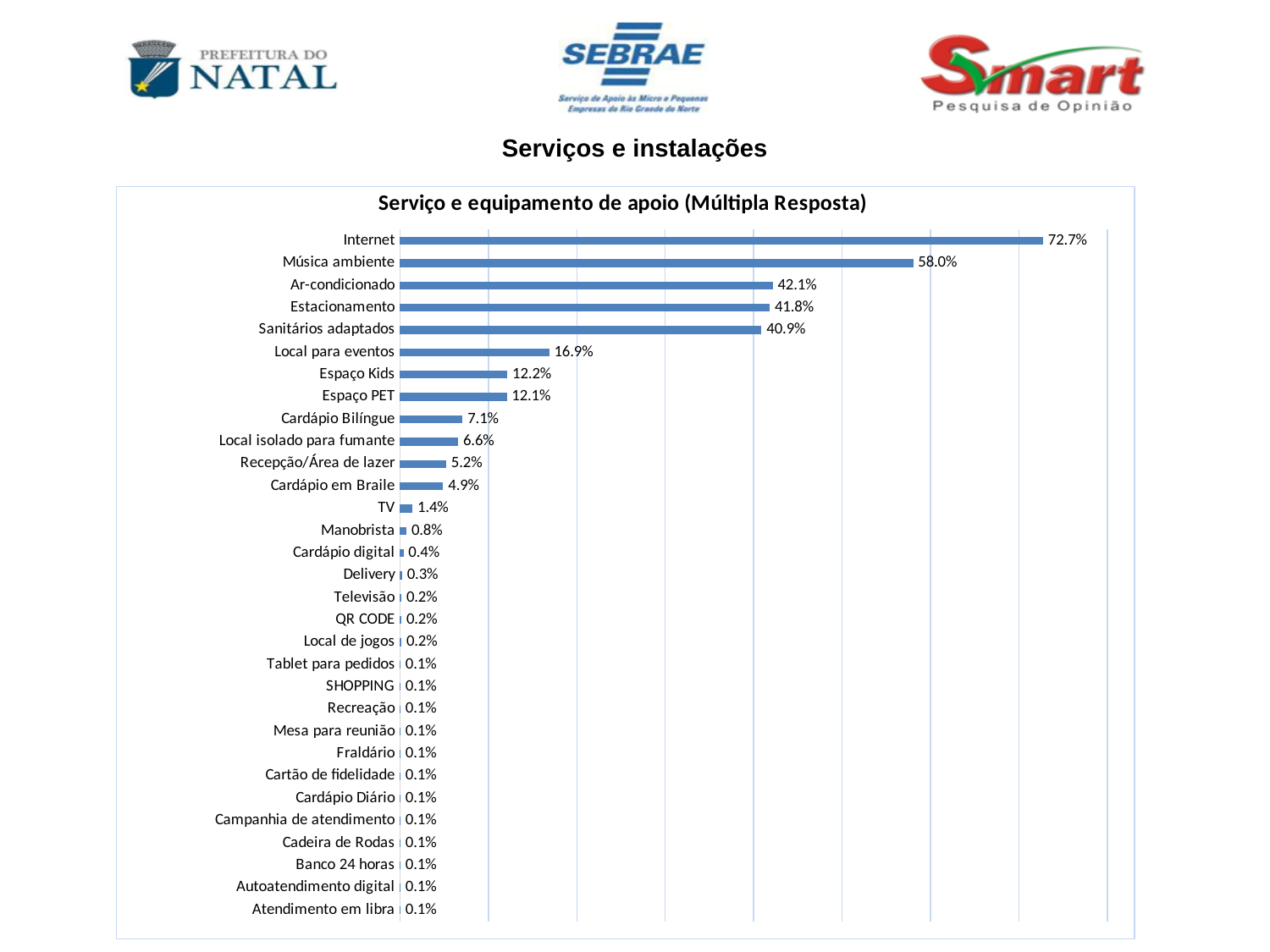
What is the difference between the values for Ar-condicionado and Sanitários adaptados? 1.2% What is the value for Manobrista? 0.8% What is the difference between the values for Internet and Música ambiente? 14.7% What kind of chart is this? Bar chart What is the value for Cardápio em Braile? 4.9% How many categories are shown in the chart? 31 What is the value for Estacionamento? 41.8% Which category has the highest value? Internet What is the value for Internet? 72.7% What is the value for Espaço PET? 12.1% Which is larger, the value for Local para eventos or the value for Espaço Kids? Local para eventos What is the title of the chart? Serviço e equipamento de apoio (Múltipla Resposta)